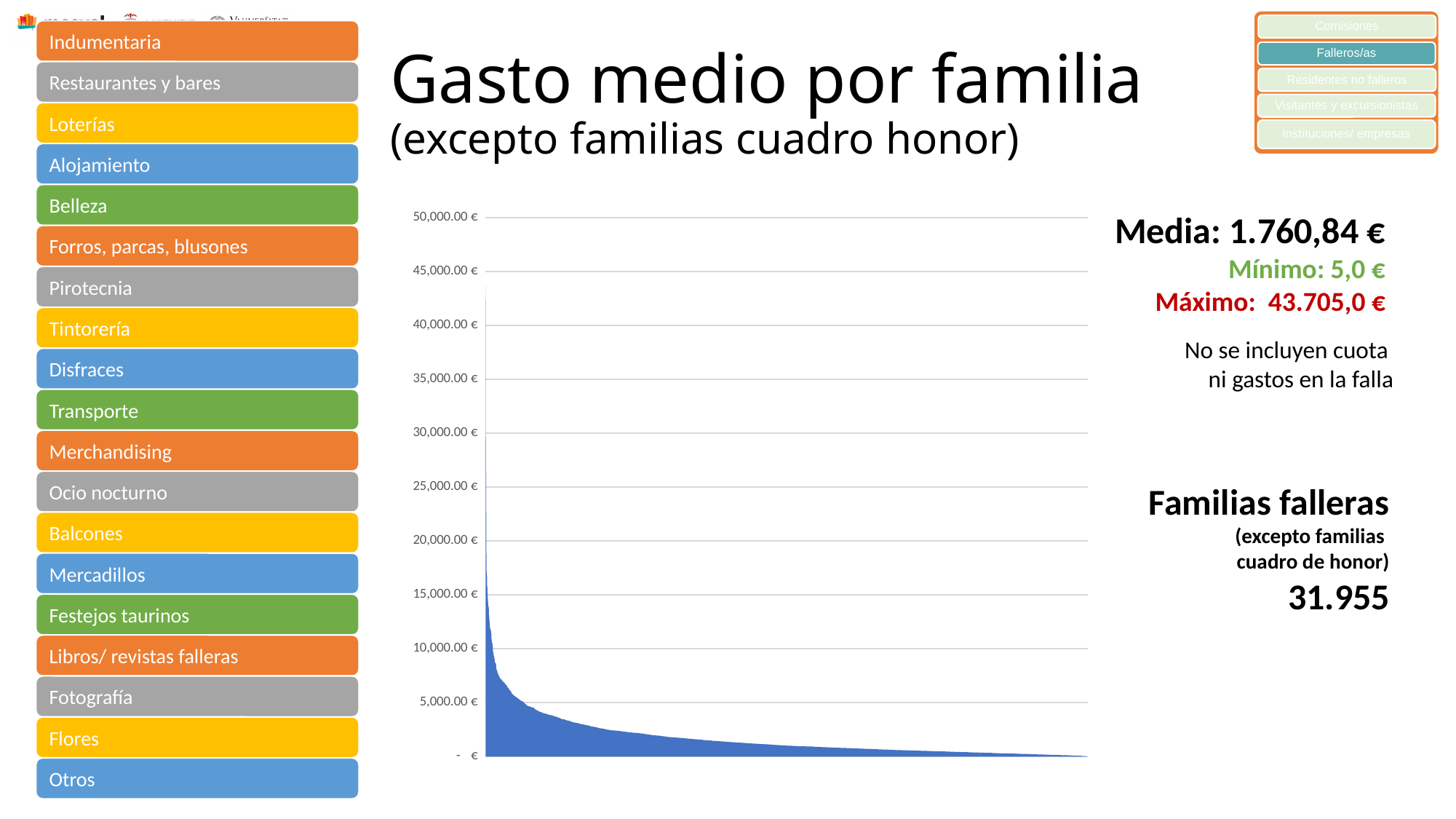
Is the stated mean (Media) greater or less than 5,000.00 €? less How many familias falleras (excepto familias cuadro de honor) does the slide say are represented? 31.955 Is the highest plotted value greater or less than 40,000.00 €? greater What is the mean (Media) value stated next to the chart? 1.760,84 € What kind of chart is shown on the slide? area chart What is the maximum (Máximo) value stated next to the chart? 43.705,0 € Do the plotted values rise or fall from left to right along the x axis? fall Is the value at the far right end of the chart greater or less than 5,000.00 €? less What is the highest tick label shown on the chart's y axis? 50,000.00 € What is the minimum (Mínimo) value stated next to the chart? 5,0 € What is the title of the slide containing the chart? Gasto medio por familia (excepto familias cuadro honor)